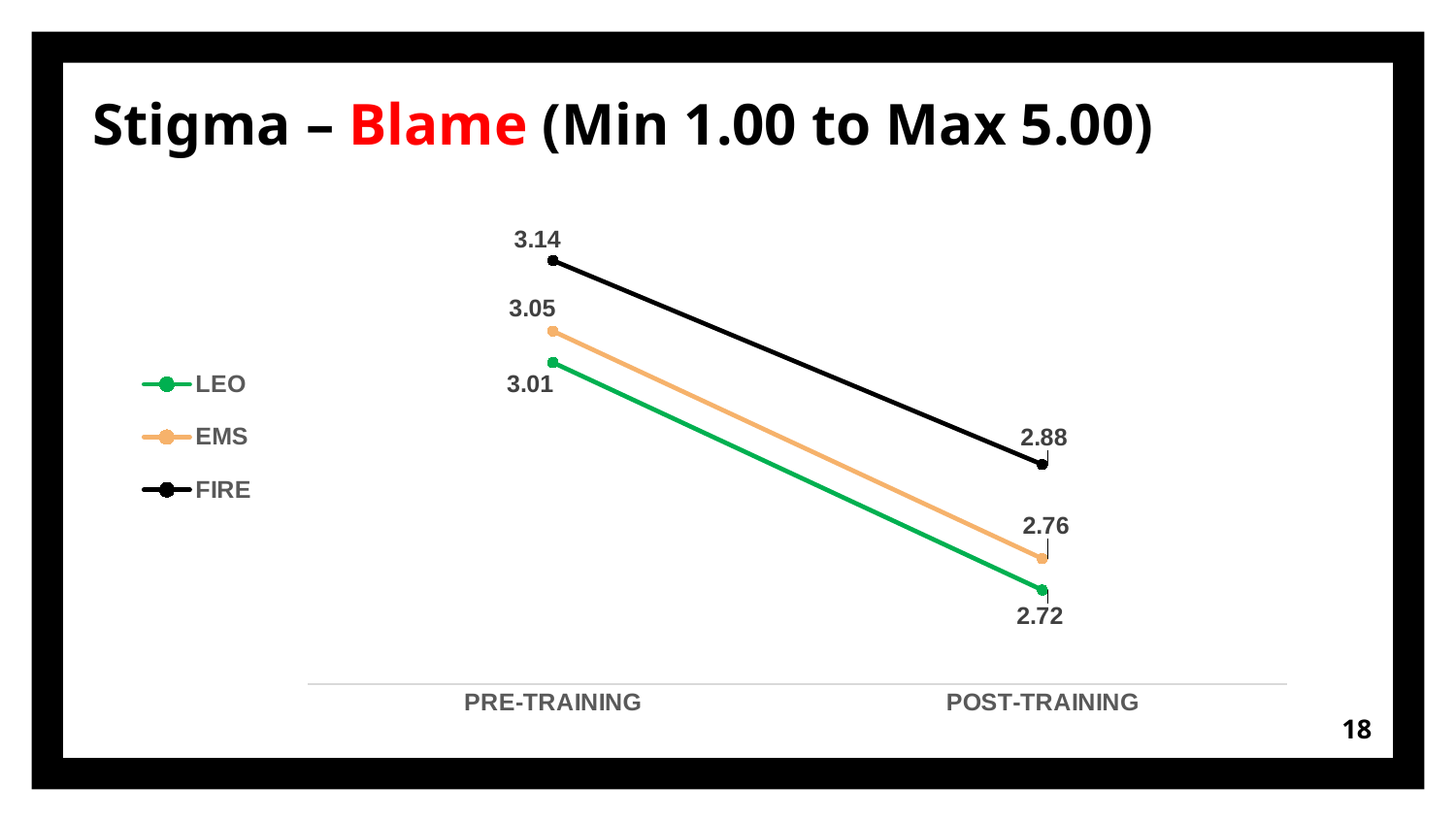
What kind of chart is shown on the slide? Line chart What is the POST-TRAINING value for LEO? 2.72 What is the PRE-TRAINING value for LEO? 3.01 What is the difference between the PRE-TRAINING and POST-TRAINING values for FIRE? 0.26 How many series does the legend list? 3 What is the difference between the PRE-TRAINING and POST-TRAINING values for EMS? 0.29 What is the POST-TRAINING value for EMS? 2.76 Do the values for LEO rise or fall from PRE-TRAINING to POST-TRAINING? Fall Which series has the lowest value at PRE-TRAINING? LEO Which series has the highest value at POST-TRAINING? FIRE What is the PRE-TRAINING value for FIRE? 3.14 Which is larger: the PRE-TRAINING value for EMS or the PRE-TRAINING value for FIRE? FIRE